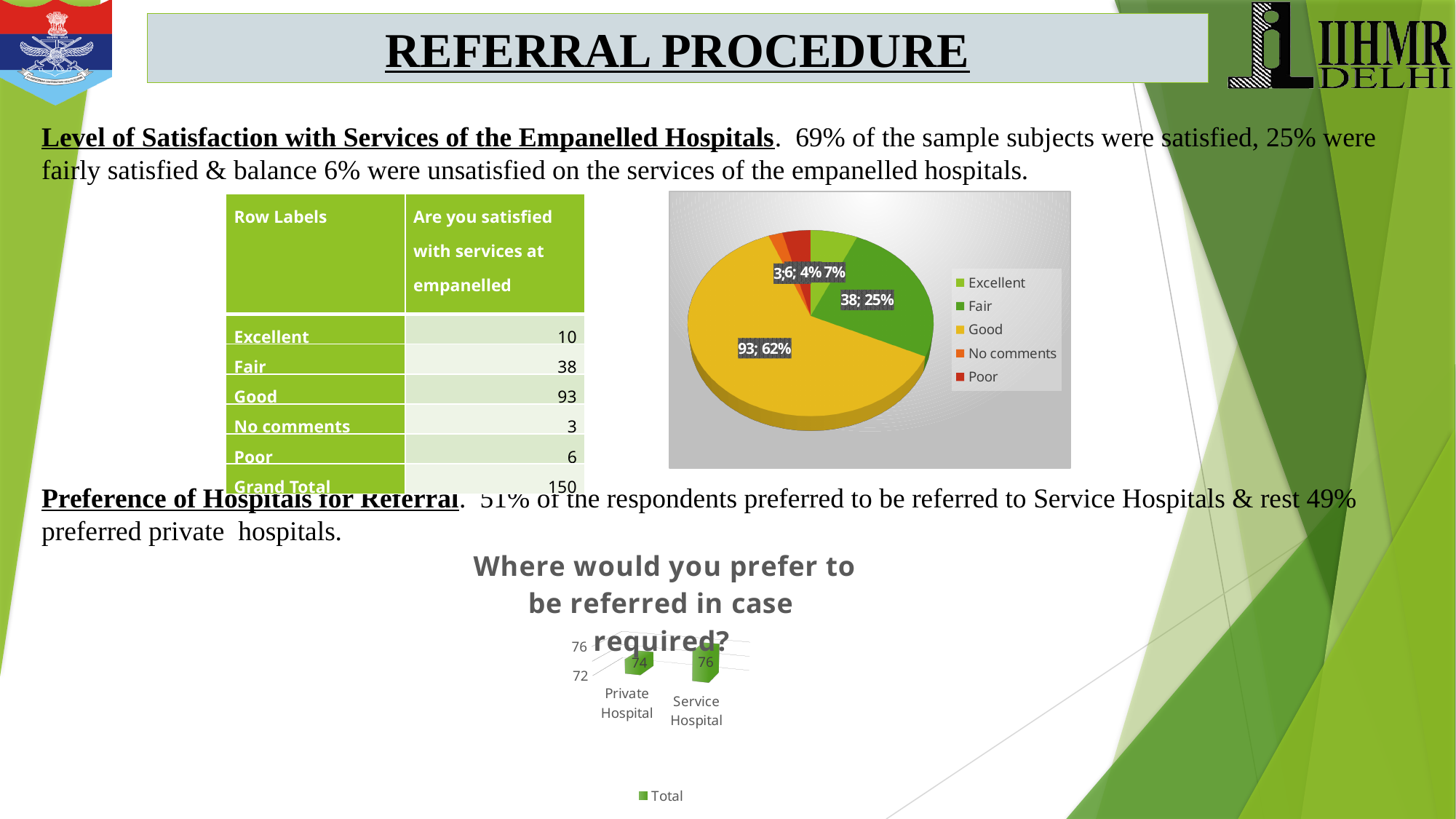
In the pie chart, what percentage share is shown for the Good slice? 62% In the pie chart, what value is shown for the Fair slice? 38 In the chart titled 'Where would you prefer to be referred in case required?', which category has the higher value, Private Hospital or Service Hospital? Service Hospital In the pie chart, what percentage share is shown for the Fair slice? 25% What kind of chart is the one titled 'Where would you prefer to be referred in case required?'? Bar chart In the pie chart, what is the difference between the Good value and the Fair value? 55 In the chart titled 'Where would you prefer to be referred in case required?', what is the value for Service Hospital? 76 In the pie chart, what value is shown for the Good slice? 93 How many categories does the legend of the pie chart list? 5 In the pie chart, which category has the largest slice? Good In the chart titled 'Where would you prefer to be referred in case required?', what is the value for Private Hospital? 74 What series name does the legend of the chart titled 'Where would you prefer to be referred in case required?' show? Total